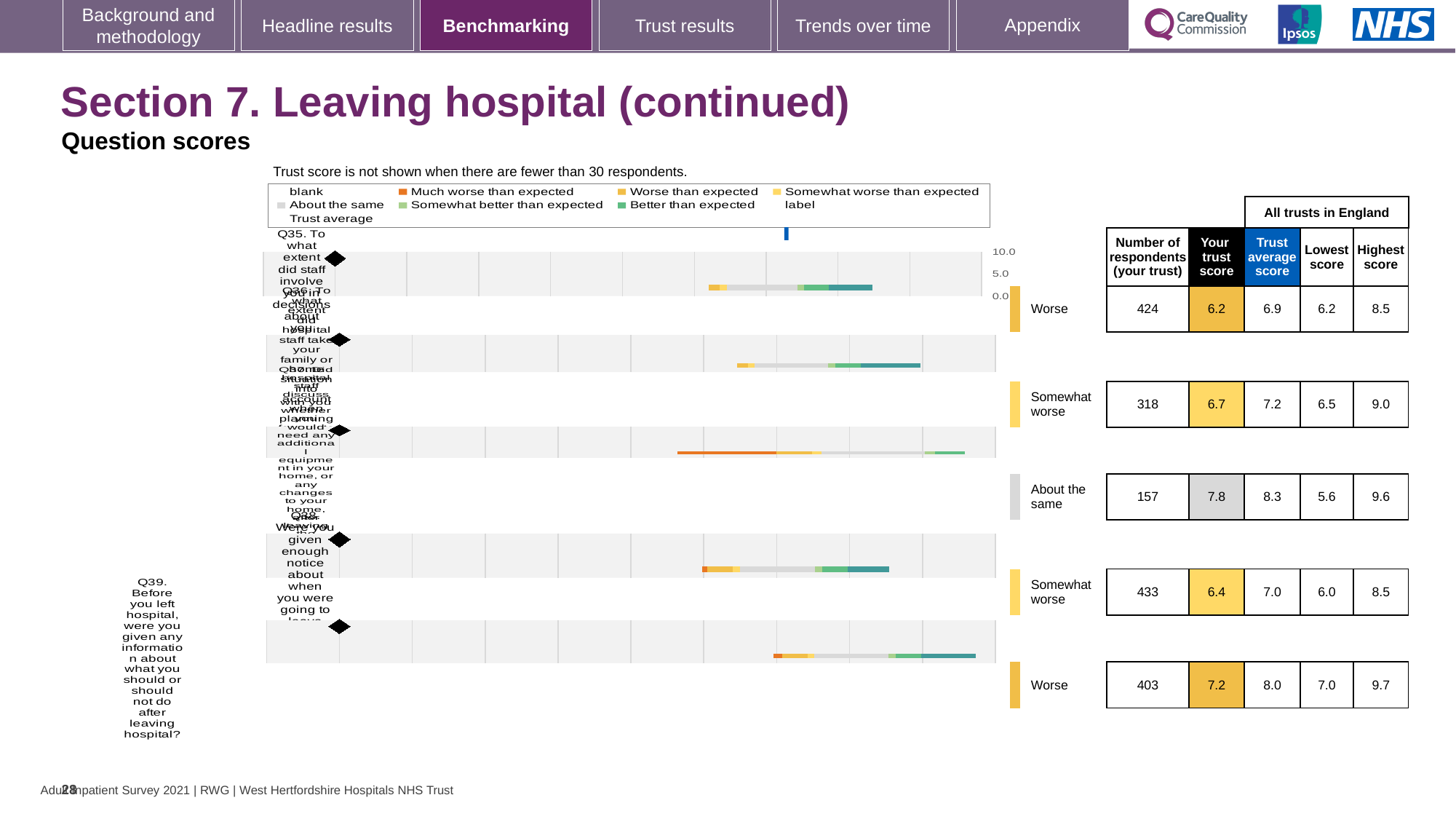
How many respondents are shown for Q39 (the last row of the chart)? 403 What is the 'Lowest score' value for Q38 (the fourth row)? 6.0 Which question row has the highest number of respondents? Q38 (433) For Q35, what is the difference between the trust average score and your trust score? 0.7 What is the heading above the 'Trust average score', 'Lowest score' and 'Highest score' columns? All trusts in England What kind of chart is used to show the question scores? Bar chart What is the 'Highest score' value for Q39 (the last row)? 9.7 What is the 'Your trust score' value for Q35 (the first row of the chart)? 6.2 How many question rows are plotted in the chart? 5 Which has the higher 'Your trust score': Q35 or Q39? Q39 What benchmark category is shown for Q35 (the first row)? Worse What is the lowest number of respondents shown in the table? 157